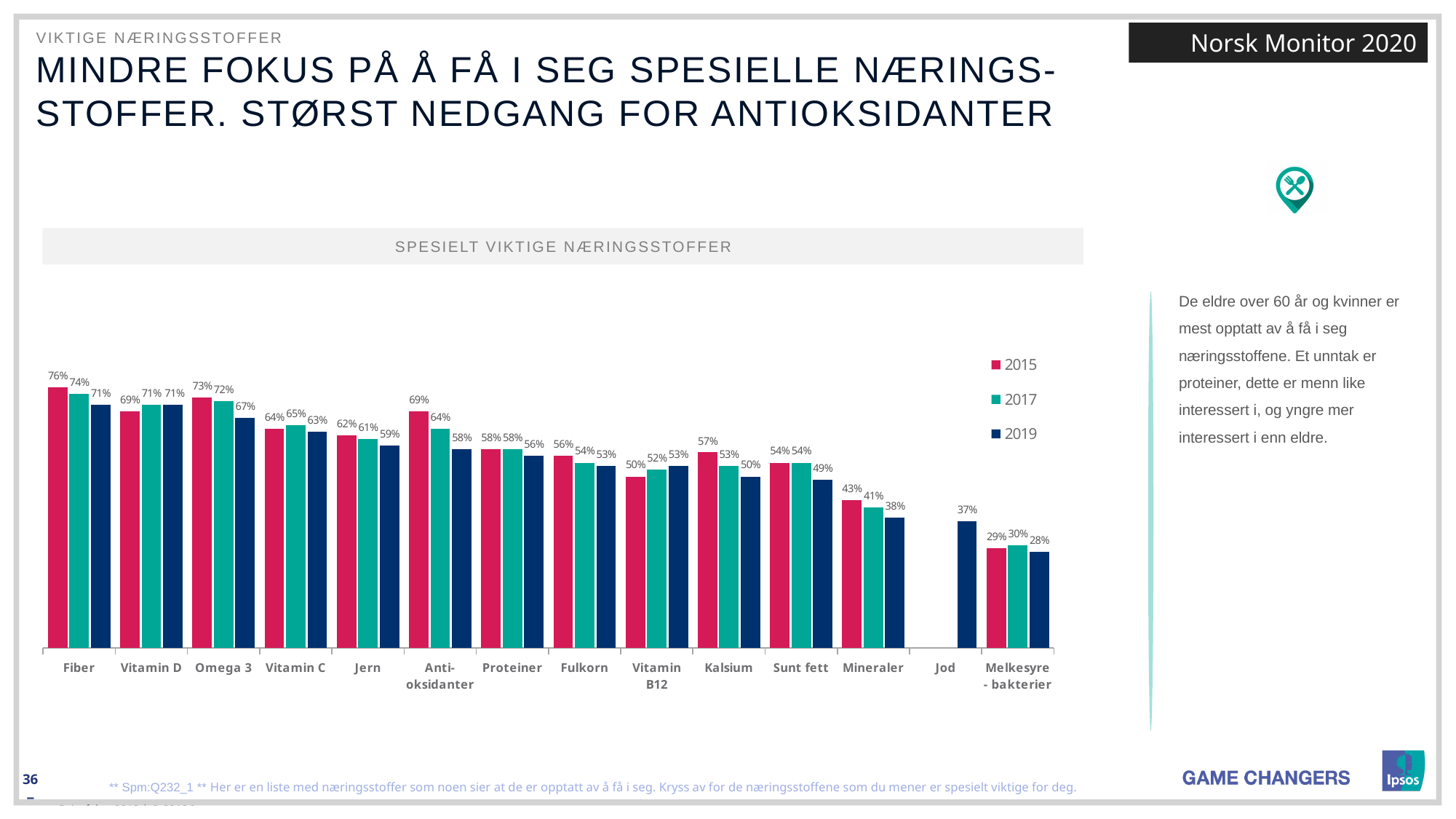
Which category had the highest value in 2019? Fiber and Vitamin D (both 71%) Which was higher in 2019: Kalsium or Vitamin B12? Vitamin B12 What was the value for Jod in 2019? 37% By how many percentage points did the value for Antioksidanter fall from 2015 to 2019? 11 percentage points How many categories are shown on the x axis? 14 What kind of chart is shown? Bar chart Which years are listed in the legend? 2015, 2017, 2019 What was the value for Antioksidanter in 2019? 58% Which category had the lowest value in 2015? Melkesyrebakterier What was the value for Fiber in 2015? 76% Did the value for Vitamin B12 rise or fall from 2015 to 2019? Rise How many series does the legend list? 3